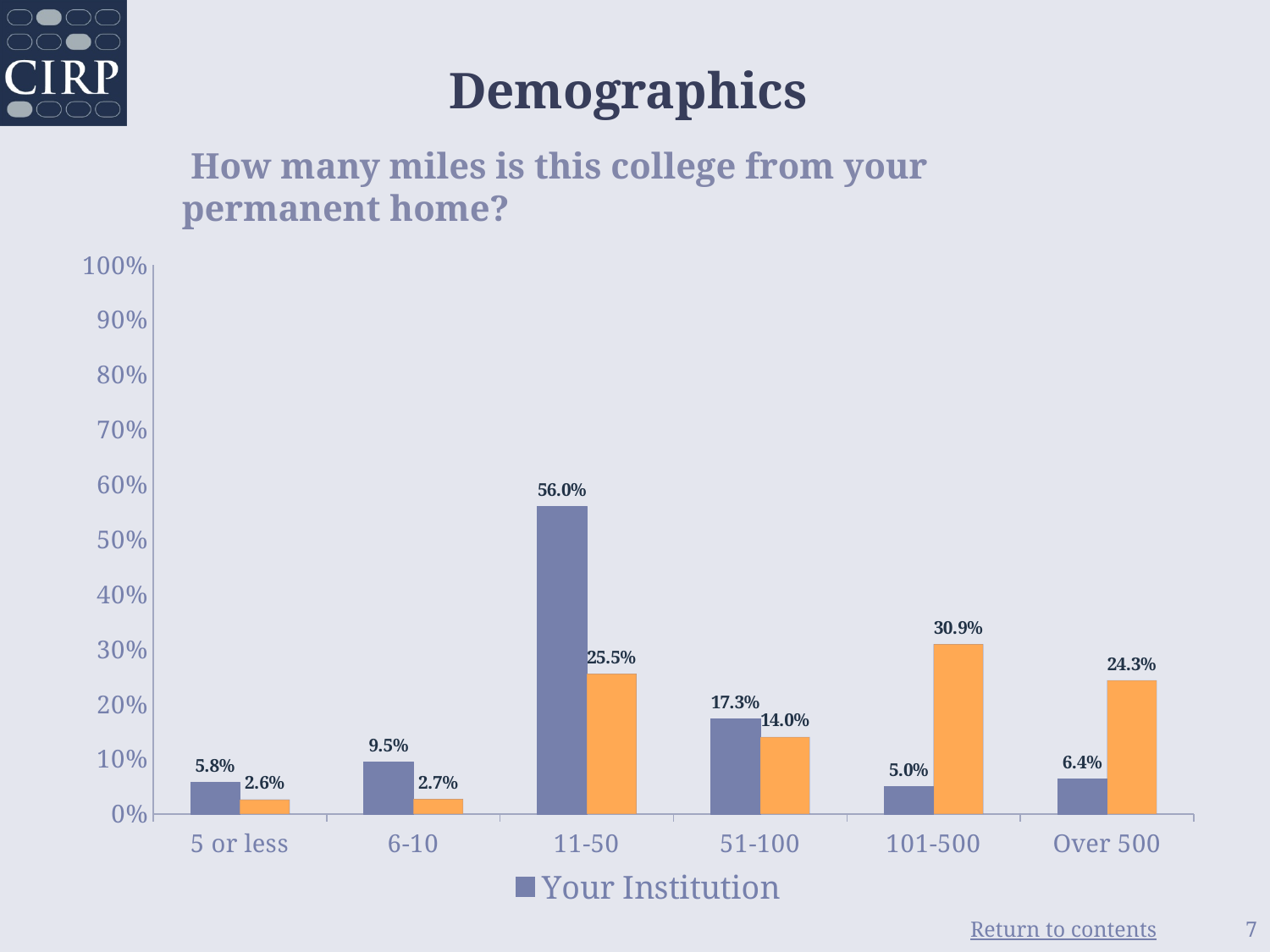
What is the value for Your Institution in the 101-500 category? 5.0% What is the value for Your Institution in the 11-50 category? 56.0% How many categories are shown on the x axis? 6 What is the value of the orange bar for the Over 500 category? 24.3% Which category has the lowest value for Your Institution? 101-500 Which category has the highest value for Your Institution? 11-50 Which category has the lowest orange bar? 5 or less Is the value for Your Institution in the 11-50 category greater or less than 50%? greater How many series does the legend list? 1 What is the difference between the Your Institution value and the orange bar value in the 11-50 category? 30.5% What kind of chart is shown on the slide? bar chart In the 101-500 category, which is larger: the Your Institution bar or the orange bar? the orange bar